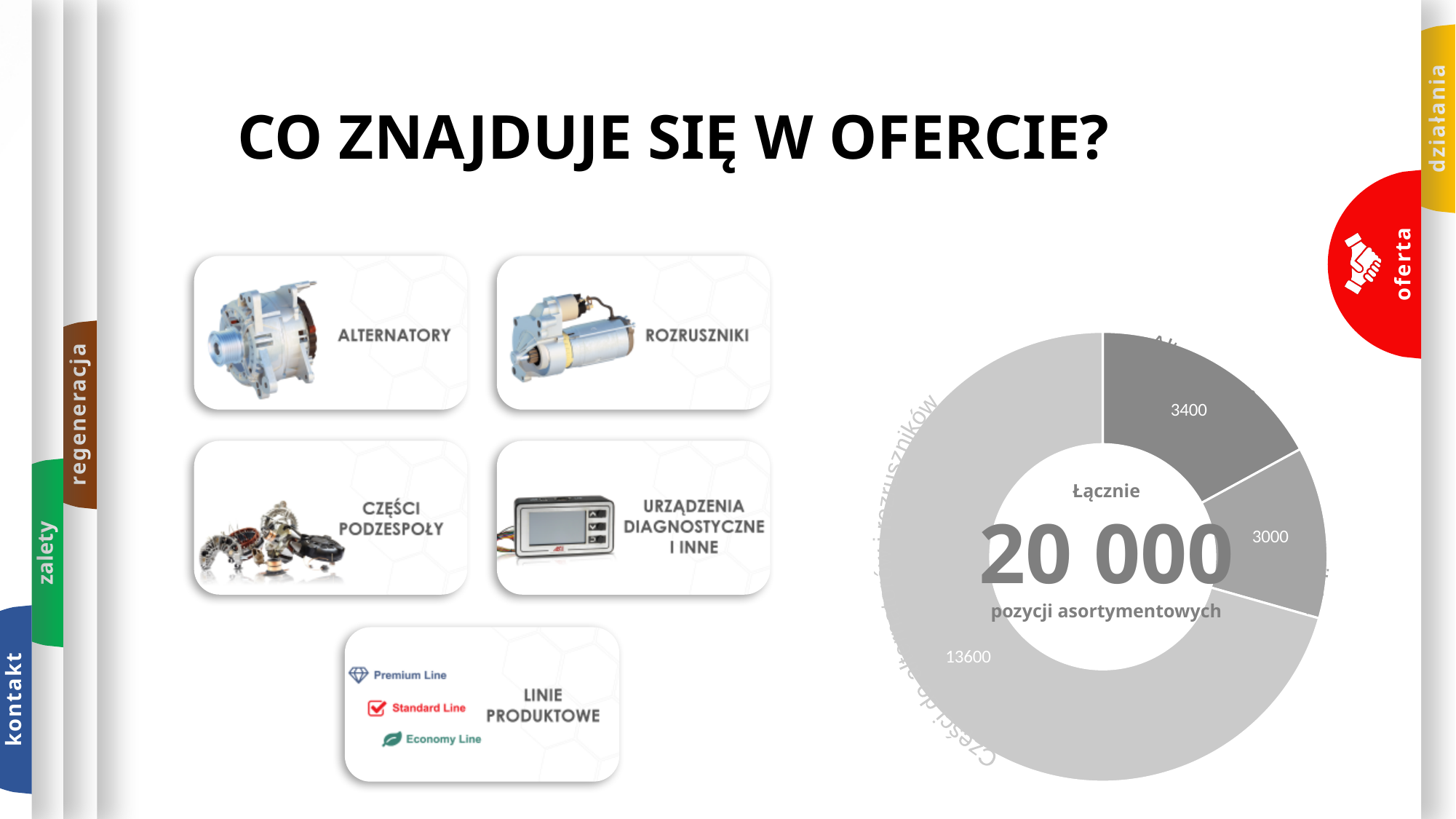
What is the value of the largest slice in the doughnut chart? 13600 What kind of chart is shown on the right side of the slide? doughnut chart What is the value of the smallest slice in the doughnut chart? 3000 Which is larger in the doughnut chart: the slice labelled 3400 or the slice labelled 3000? 3400 How many slices does the doughnut chart have? 3 What share of the doughnut chart total does the slice labelled 13600 represent? 68% What is the difference between the largest slice (13600) and the smallest slice (3000) in the doughnut chart? 10600 What number is displayed in the centre of the doughnut chart? 20 000 What share of the doughnut chart total does the slice labelled 3400 represent? 17% What is the difference between the slices labelled 3400 and 3000 in the doughnut chart? 400 What is the total of all slices in the doughnut chart? 20 000 What value is labelled on the darkest grey slice of the doughnut chart? 3400